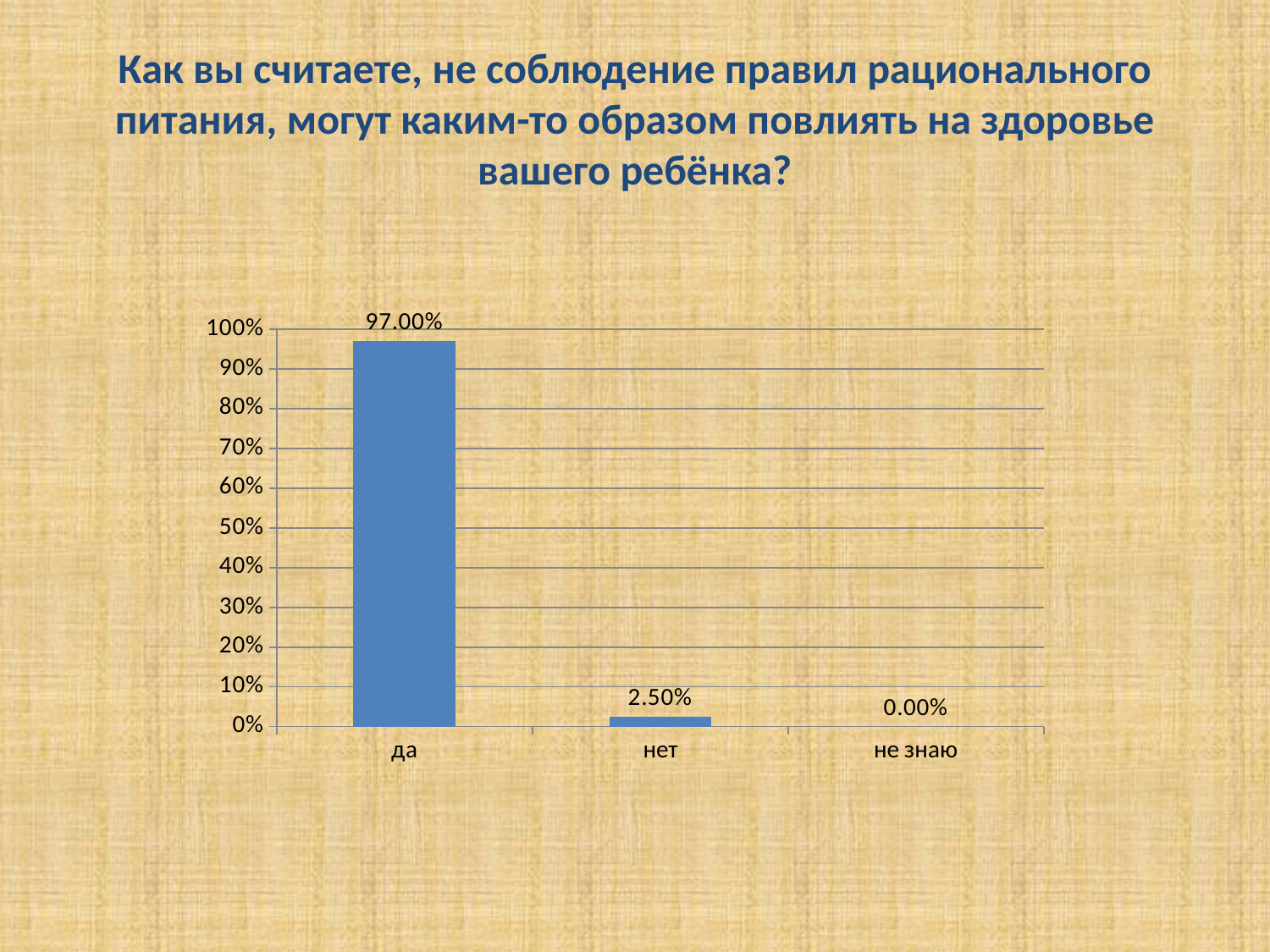
Which is larger, the value for "нет" or the value for "не знаю"? нет Is the value for "нет" greater or less than 10%? less What is the value for "нет"? 2.50% Do the values rise or fall from left to right along the x axis? fall Which category has the lowest value? не знаю Is the value for "да" greater or less than 90%? greater How many categories are shown on the x axis? 3 What kind of chart is shown on the slide? bar chart Which category has the highest value? да What is the value for "не знаю"? 0.00% What is the difference between the values for "да" and "нет"? 94.50% What is the value for "да"? 97.00%